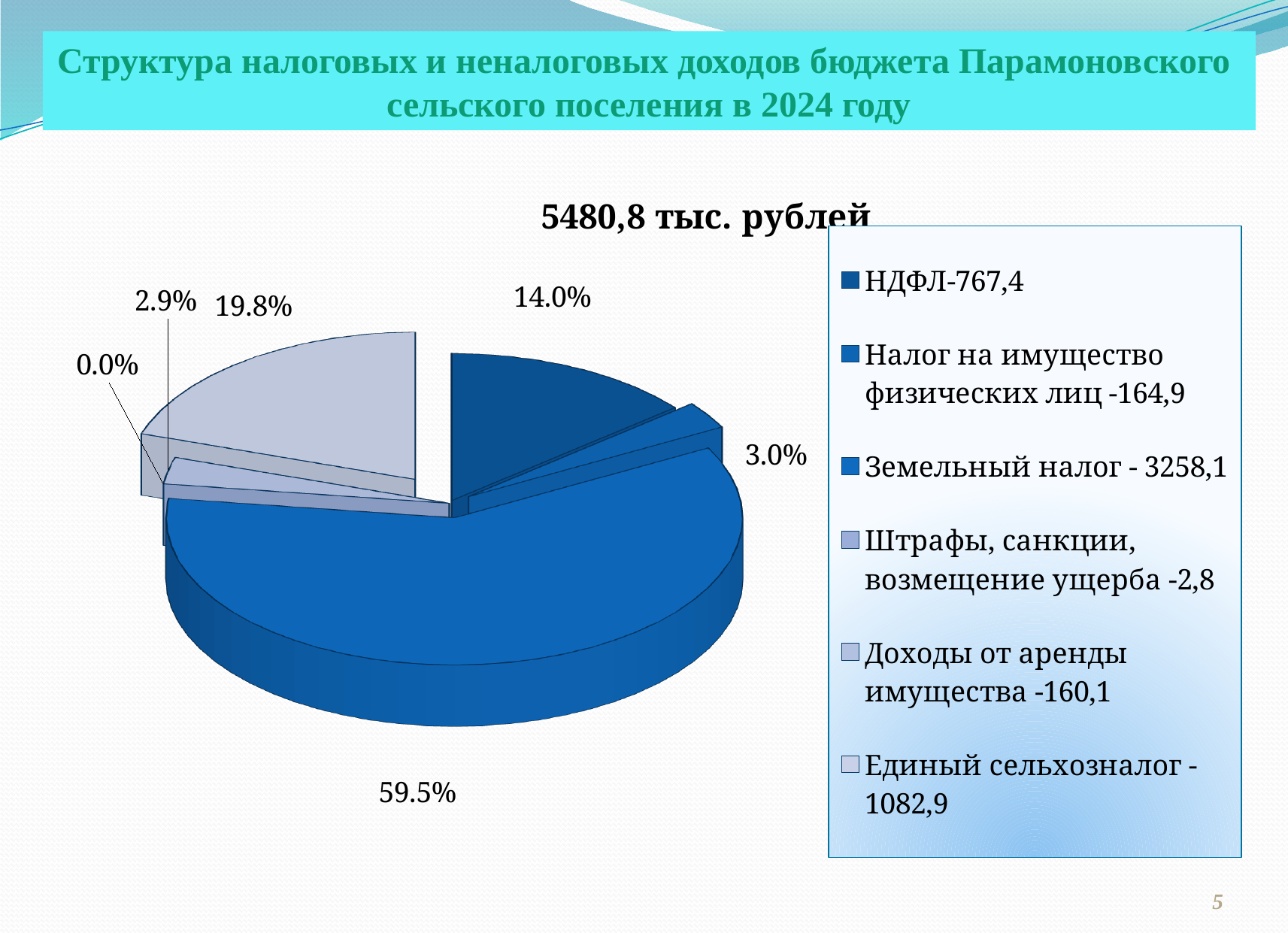
What share of the pie does Земельный налог take? 59.5% Which category has the largest share of the pie? Земельный налог What is the value for Доходы от аренды имущества given in the legend? 160,1 How many entries does the legend list? 6 What kind of chart is shown on the slide? pie chart What share of the pie does НДФЛ take? 14.0% How many slices does the pie chart have? 6 Which category has the smallest share of the pie? Штрафы, санкции, возмещение ущерба Which is larger, the share for НДФЛ or the share for Единый сельхозналог? Единый сельхозналог What is the total amount shown in the chart title? 5480,8 тыс. рублей What share of the pie does Налог на имущество физических лиц take? 3.0%